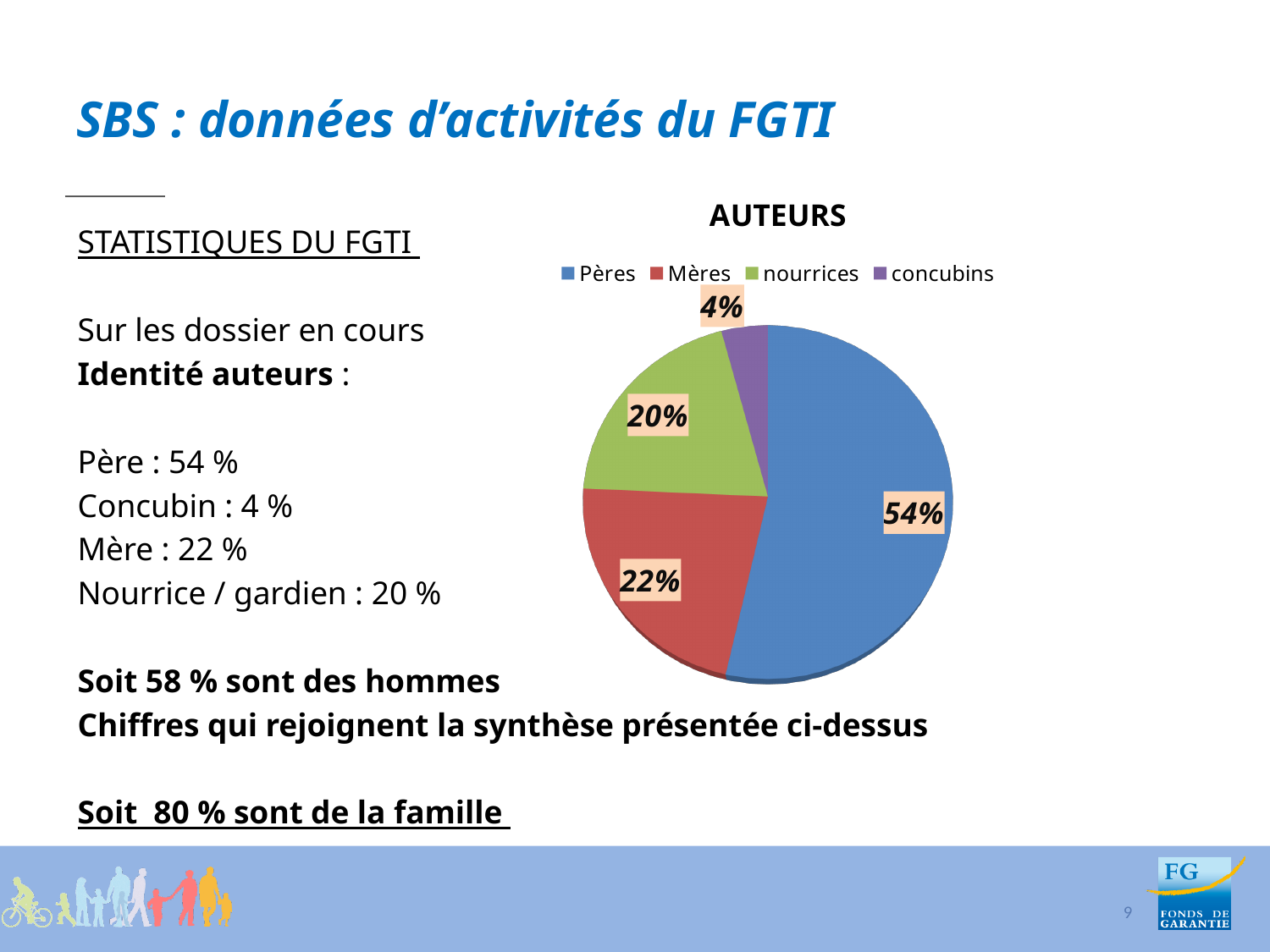
What is the title of the chart? AUTEURS Which category has the smallest slice of the pie? concubins What is the difference in percentage points between Pères and Mères? 32 How many categories does the legend list? 4 Which category has the largest slice of the pie? Pères What share of the pie does Pères represent? 54% What share of the pie does concubins represent? 4% What share of the pie does nourrices represent? 20% What colour is the slice for nourrices? green What type of chart is shown on the slide? pie chart What share of the pie does Mères represent? 22% Which is larger, the slice for Mères or the slice for nourrices? Mères